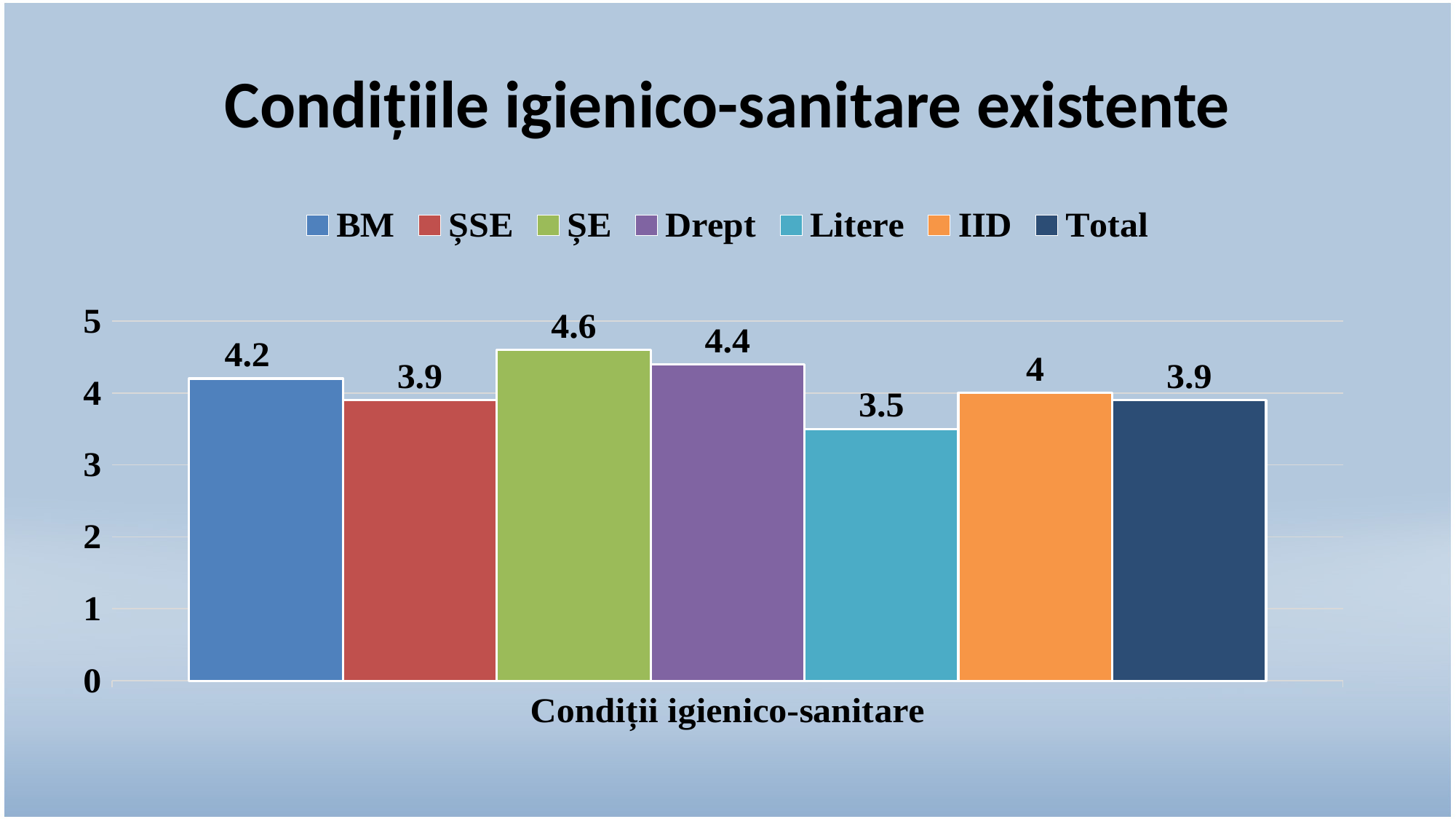
What is the value for Litere? 3.5 What kind of chart is shown on the slide? bar chart What is the difference between the values for Drept and IID? 0.4 What is the difference between the values for ȘE and Litere? 1.1 What is the value for BM? 4.2 What is the value for Total? 3.9 What is the title of the chart? Condițiile igienico-sanitare existente Which series has the highest value? ȘE Which is larger, the value for BM or the value for ȘSE? BM Which series has the lowest value? Litere What is the value for ȘE? 4.6 How many series does the legend list? 7